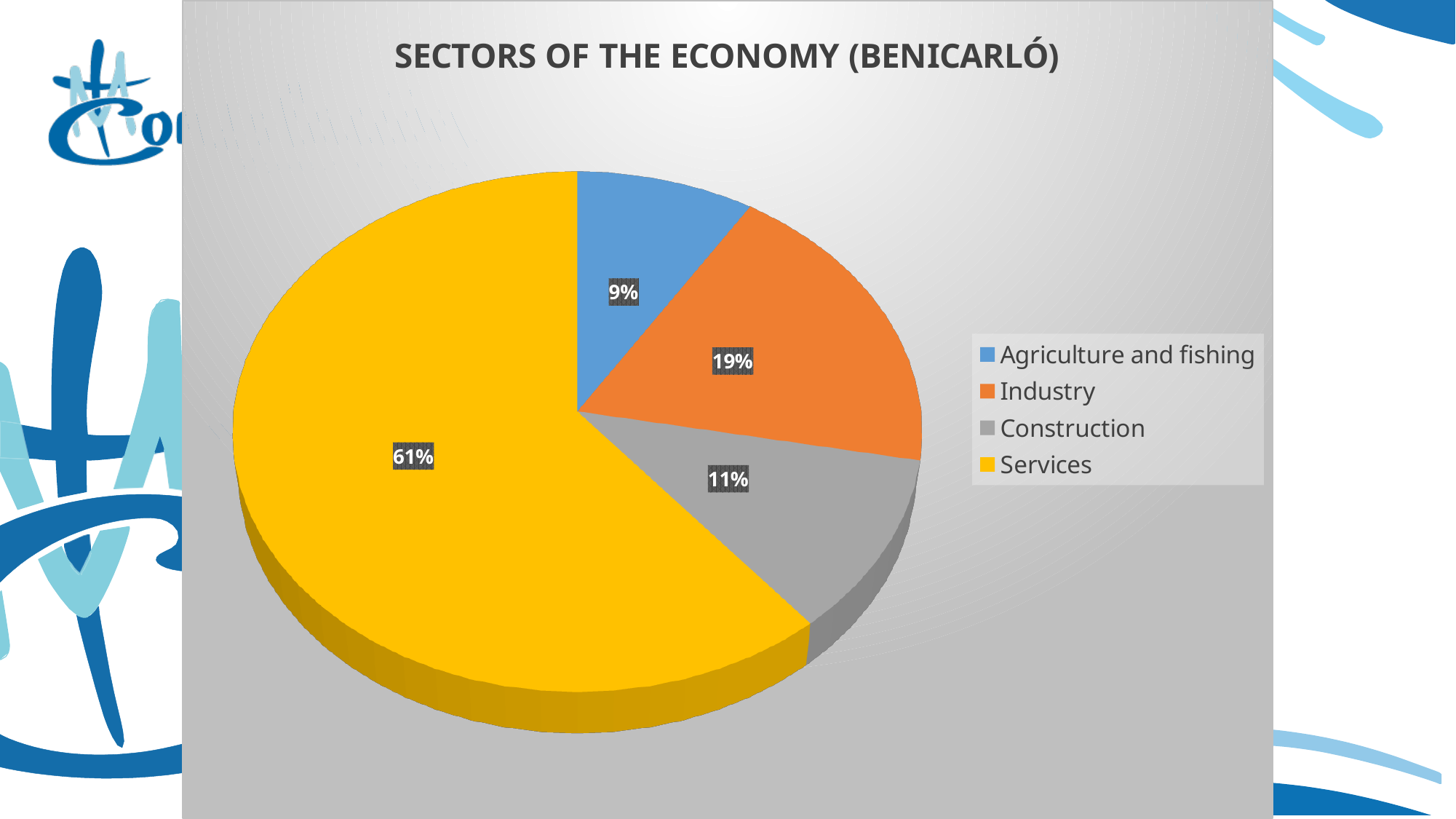
Which is larger, the share for Industry or the share for Construction? Industry What is the difference between the Industry share and the Construction share? 8% What kind of chart is shown on the slide? pie chart Which sector has the smallest share of the pie? Agriculture and fishing Which sector has the largest share of the pie? Services What percentage of the pie does Services account for? 61% What colour represents Services in the chart? yellow What is the value shown for Industry? 19% What is the value shown for Agriculture and fishing? 9% What is the title of the chart? SECTORS OF THE ECONOMY (BENICARLÓ) What is the value shown for Construction? 11% How many sectors are shown in the pie chart? 4